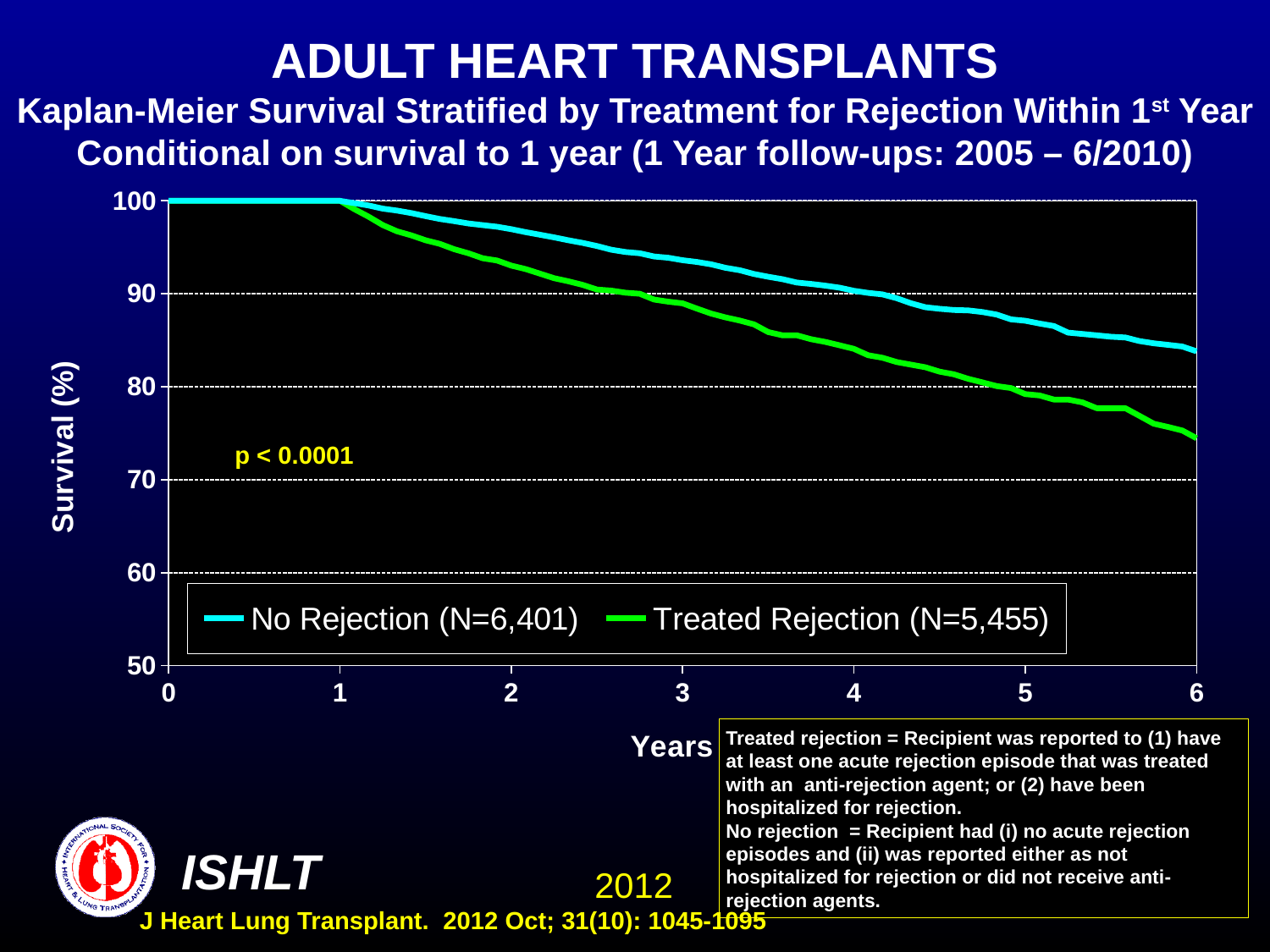
Do the survival curves rise or fall as years increase from 1 to 6? fall Is the survival value for the No Rejection group at year 3 greater or less than 90? greater Is the survival value for the Treated Rejection group at year 6 greater or less than 80? less What is the sample size (N) for the No Rejection group shown in the legend? 6,401 Is the survival value for the Treated Rejection group at year 6 greater or less than 70? greater How many series does the legend list? 2 Which group has the higher survival at year 6, No Rejection or Treated Rejection? No Rejection What type of chart is shown on the slide? line chart What is the survival value for both groups at year 1? 100 What is the sample size (N) for the Treated Rejection group shown in the legend? 5,455